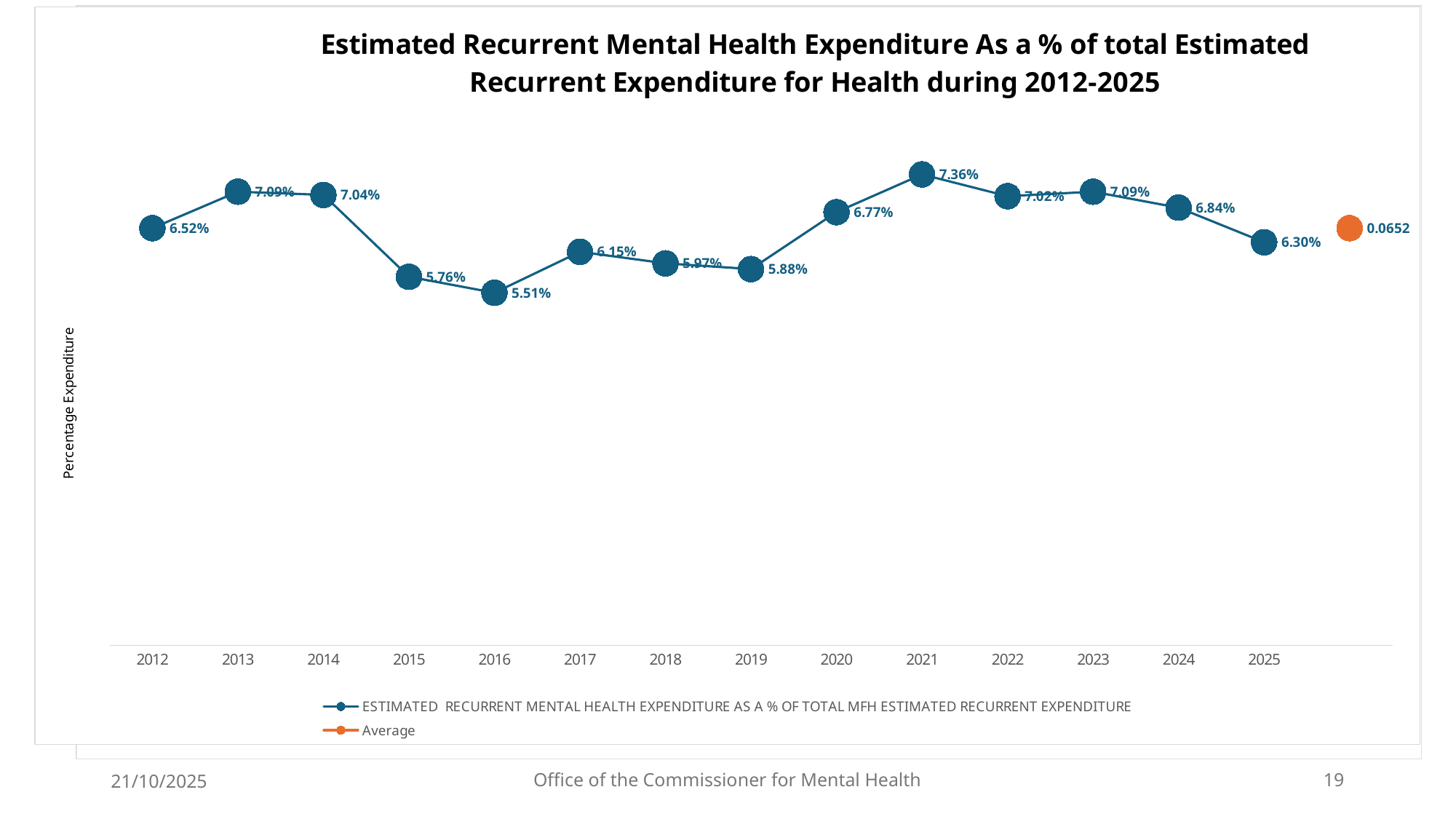
Which year has the lowest value? 2016 What is the value for 2021? 7.36% How many series does the legend list? 2 Which is larger, the value for 2020 or the value for 2017? 2020 What is the value for 2016? 5.51% What value is shown for the Average point? 0.0652 Which year has the highest value? 2021 How many years are shown on the x axis? 14 What is the difference between the values for 2021 and 2016? 1.85 percentage points What is the value for 2025? 6.30% What kind of chart is this? Line chart What is the value for 2012? 6.52%